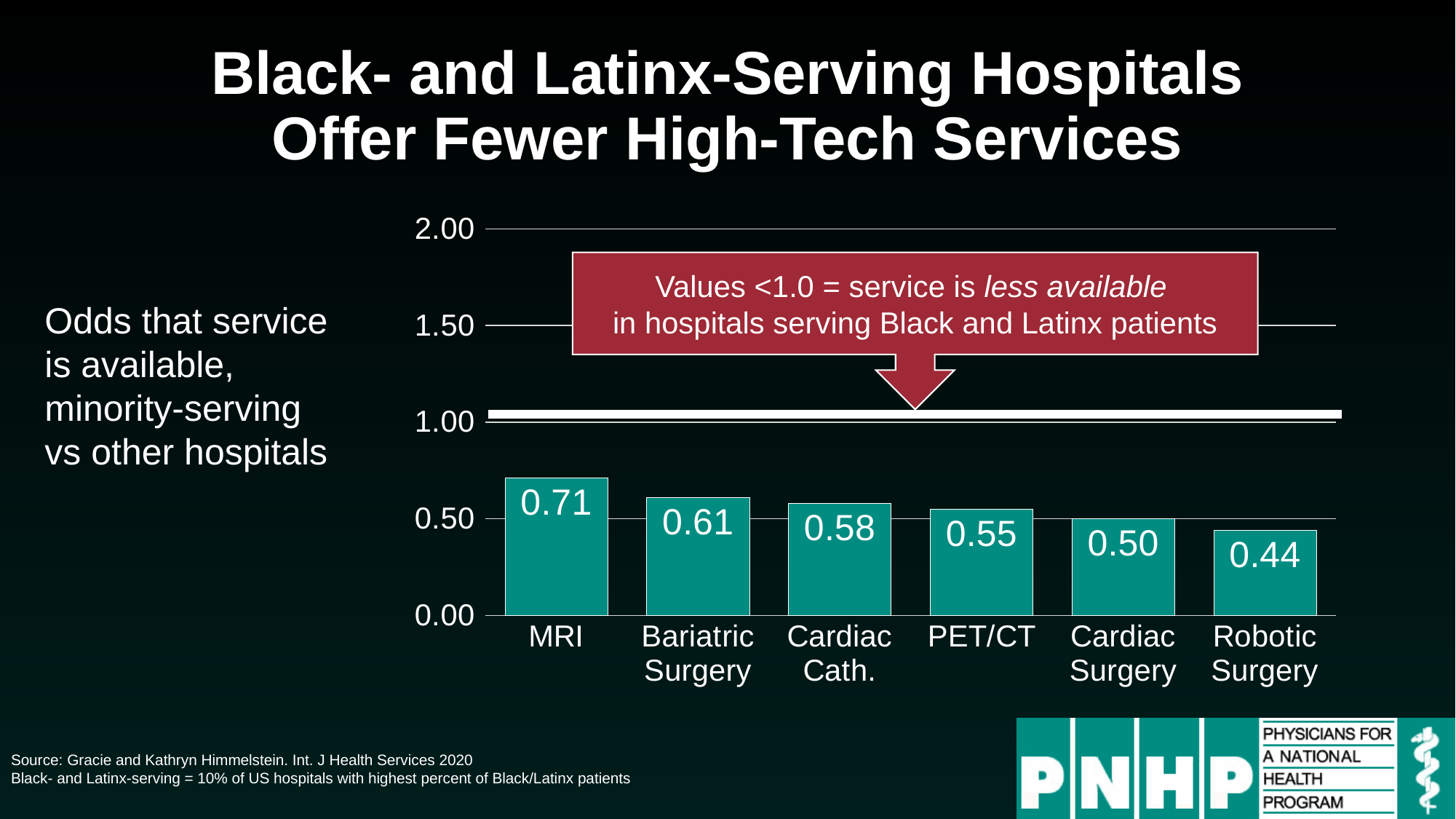
What is the odds value for Robotic Surgery? 0.44 Which has a larger odds value, Bariatric Surgery or Cardiac Surgery? Bariatric Surgery Which service has the lowest odds value? Robotic Surgery What is the odds value for Cardiac Cath.? 0.58 What is the difference between the odds values for Bariatric Surgery and PET/CT? 0.06 Is the value for PET/CT greater or less than 1.00? less Which service has the highest odds value? MRI What is the odds value for MRI? 0.71 What kind of chart is shown on the slide? bar chart What is the difference between the odds values for MRI and Robotic Surgery? 0.27 How many services are shown on the chart? 6 Do the values rise or fall from left to right across the x axis? fall